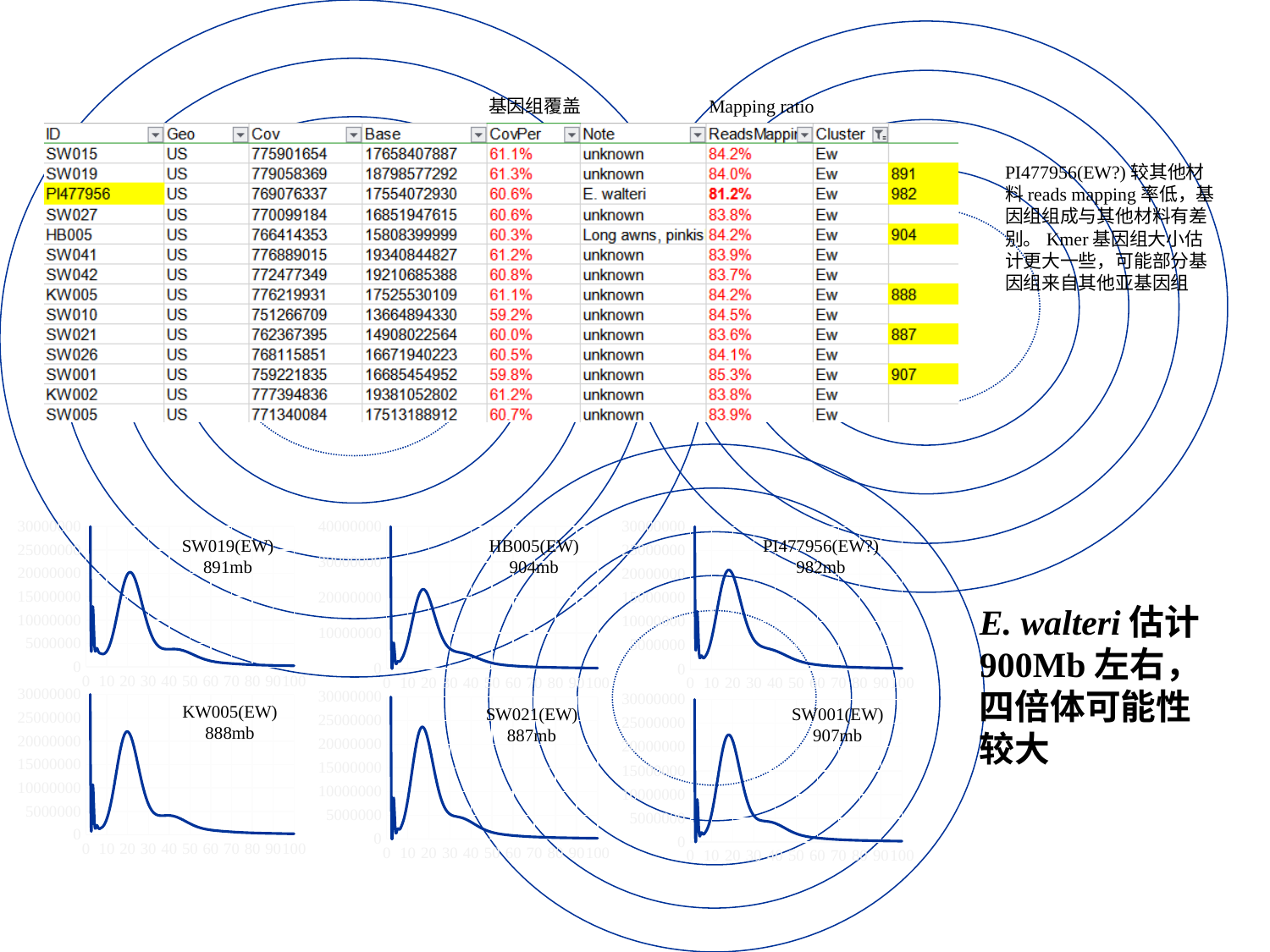
What genome size estimate is printed on the PI477956(EW?) chart? 982mb What genome size estimate is printed on the SW021(EW) chart? 887mb Which genome size estimate is larger, the one on the SW001(EW) chart or the one on the KW005(EW) chart? SW001(EW) In the KW005(EW) chart, after the main hump around x=20, do the values rise or fall as x increases toward 100? fall What kind of chart is the SW019(EW) chart in the lower left of the slide? line chart Which of the six charts shows the largest genome size estimate? PI477956(EW?) In the SW019(EW) chart, is the peak of the main hump (around x=20) greater or less than 15000000? greater In the HB005(EW) chart, is the peak of the main hump (around x=20) greater or less than 10000000? greater How many k-mer spectrum charts are shown in the lower part of the slide? 6 Which of the six charts shows the smallest genome size estimate? SW021(EW) What genome size estimate is printed on the HB005(EW) chart? 904mb What is the highest y-axis tick shown on the HB005(EW) chart? 40000000